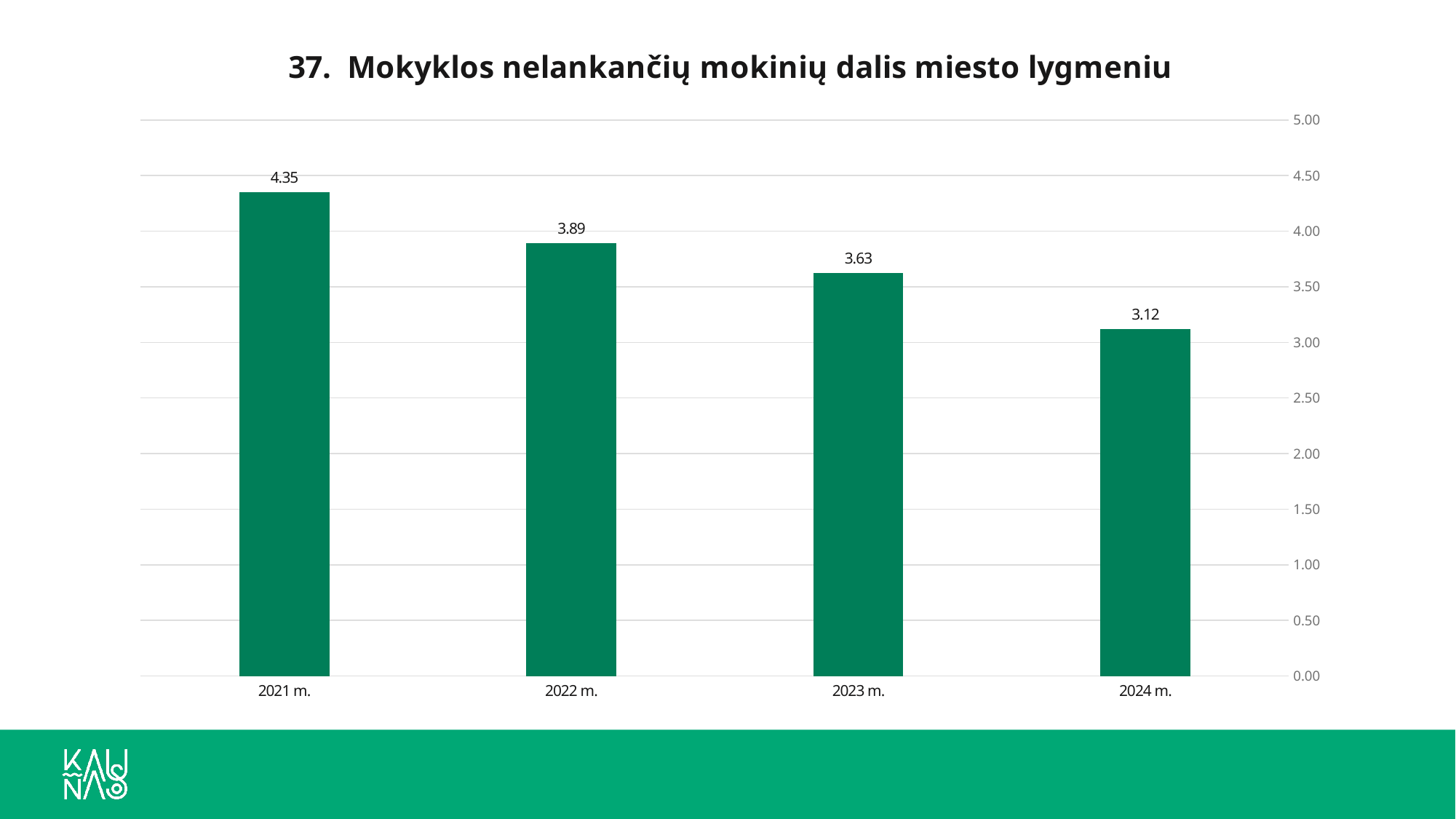
What is the value for 2022 m.? 3.89 Is the value for 2024 m. greater or less than 3.50? less Which year has the lowest value? 2024 m. What kind of chart is shown on the slide? bar chart What is the value for 2023 m.? 3.63 Do the values rise or fall from 2021 m. to 2024 m.? fall What is the value for 2021 m.? 4.35 Which year has the highest value? 2021 m. What is the value for 2024 m.? 3.12 What is the difference between the values for 2021 m. and 2024 m.? 1.23 Which is larger, the value for 2022 m. or the value for 2023 m.? 2022 m. How many years are shown on the chart? 4